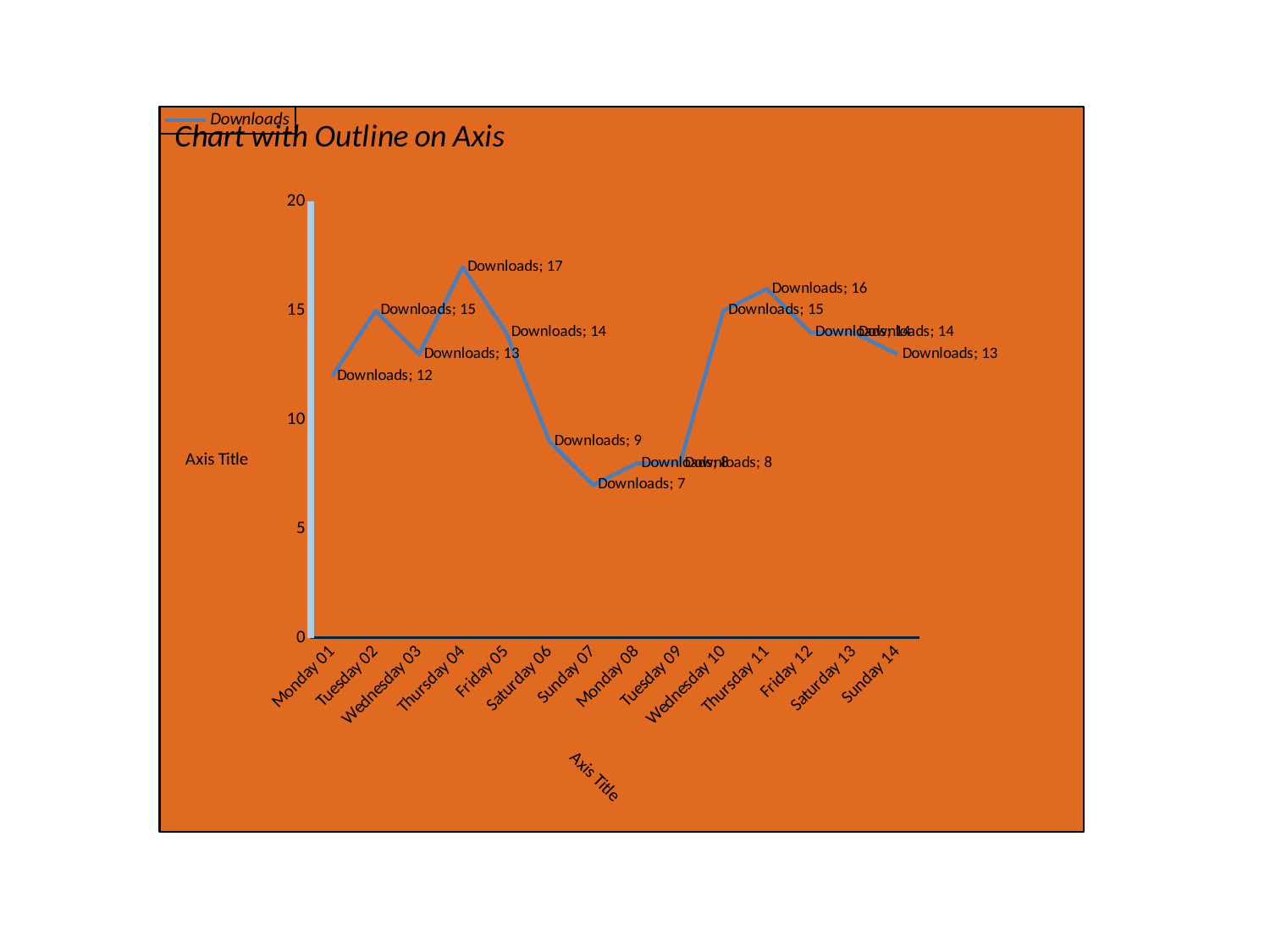
What is the Downloads value for Saturday 06? 9 What is the Downloads value for Thursday 11? 16 What kind of chart is shown on the slide? Line chart Which day has the lowest Downloads value? Sunday 07 How many data points are plotted along the x axis? 14 Do the Downloads values rise or fall from Thursday 04 to Sunday 07? Fall What is the Downloads value for Thursday 04? 17 Which day has the highest Downloads value? Thursday 04 What is the difference between the Downloads values for Thursday 04 and Sunday 07? 10 What is the Downloads value for Monday 01? 12 What is the title of the chart? Chart with Outline on Axis How many series does the legend list? 1